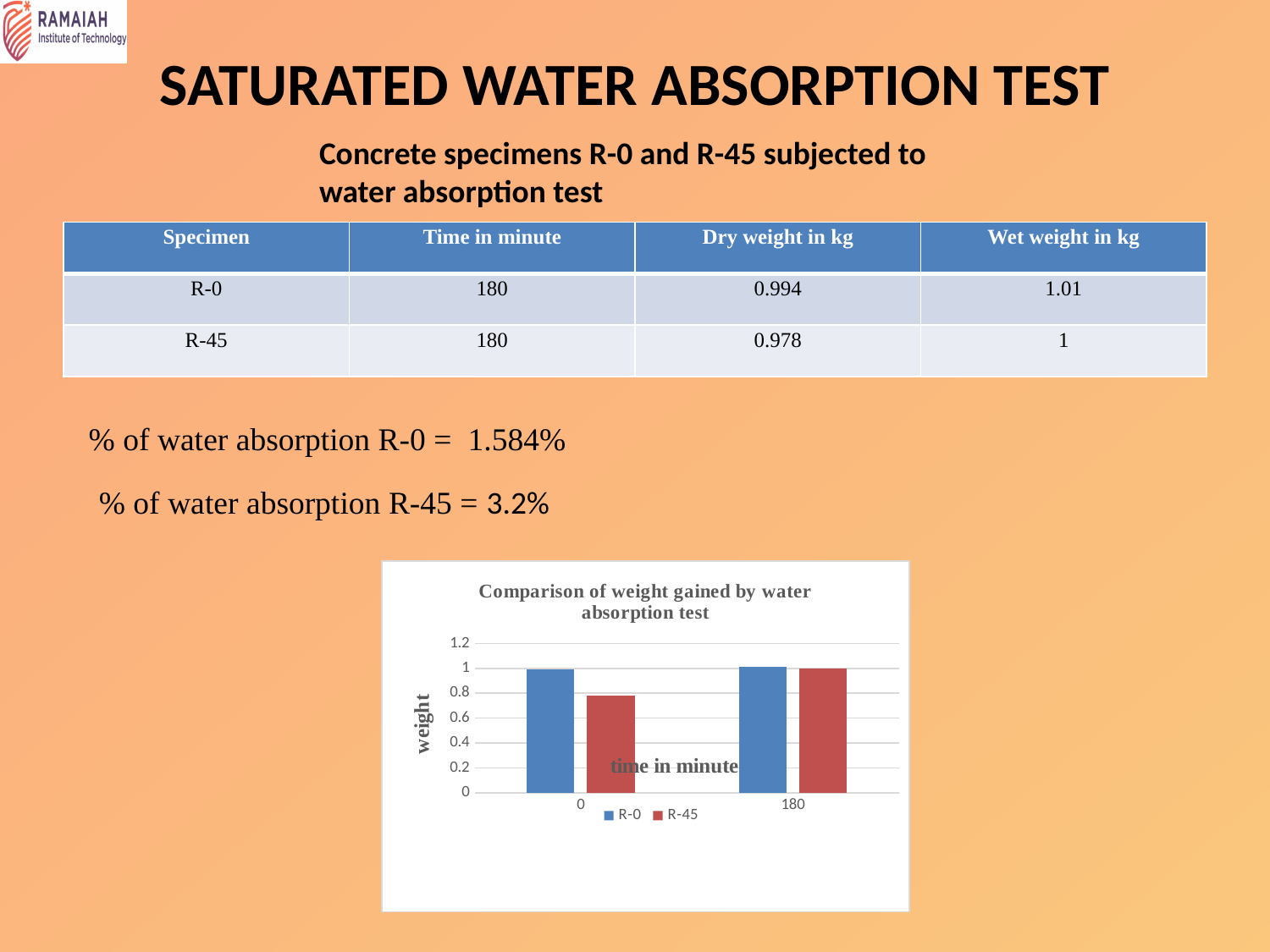
Does the value for R-45 rise or fall from time 0 to time 180? rise At time 0, which series has the larger bar, R-0 or R-45? R-0 What is the title of the chart? Comparison of weight gained by water absorption test Is the value for R-45 at time 180 greater or less than 0.8? greater What is the label of the vertical axis of the chart? weight Is the value for R-45 at time 0 greater or less than 1? less Is the value for R-0 at time 0 greater or less than 0.8? greater Which series is shown in red in the chart? R-45 Which bar in the chart is the lowest? R-45 at time 0 How many series does the legend of the chart list? 2 How many time categories are shown on the x axis of the chart? 2 What kind of chart is shown on the slide? bar chart